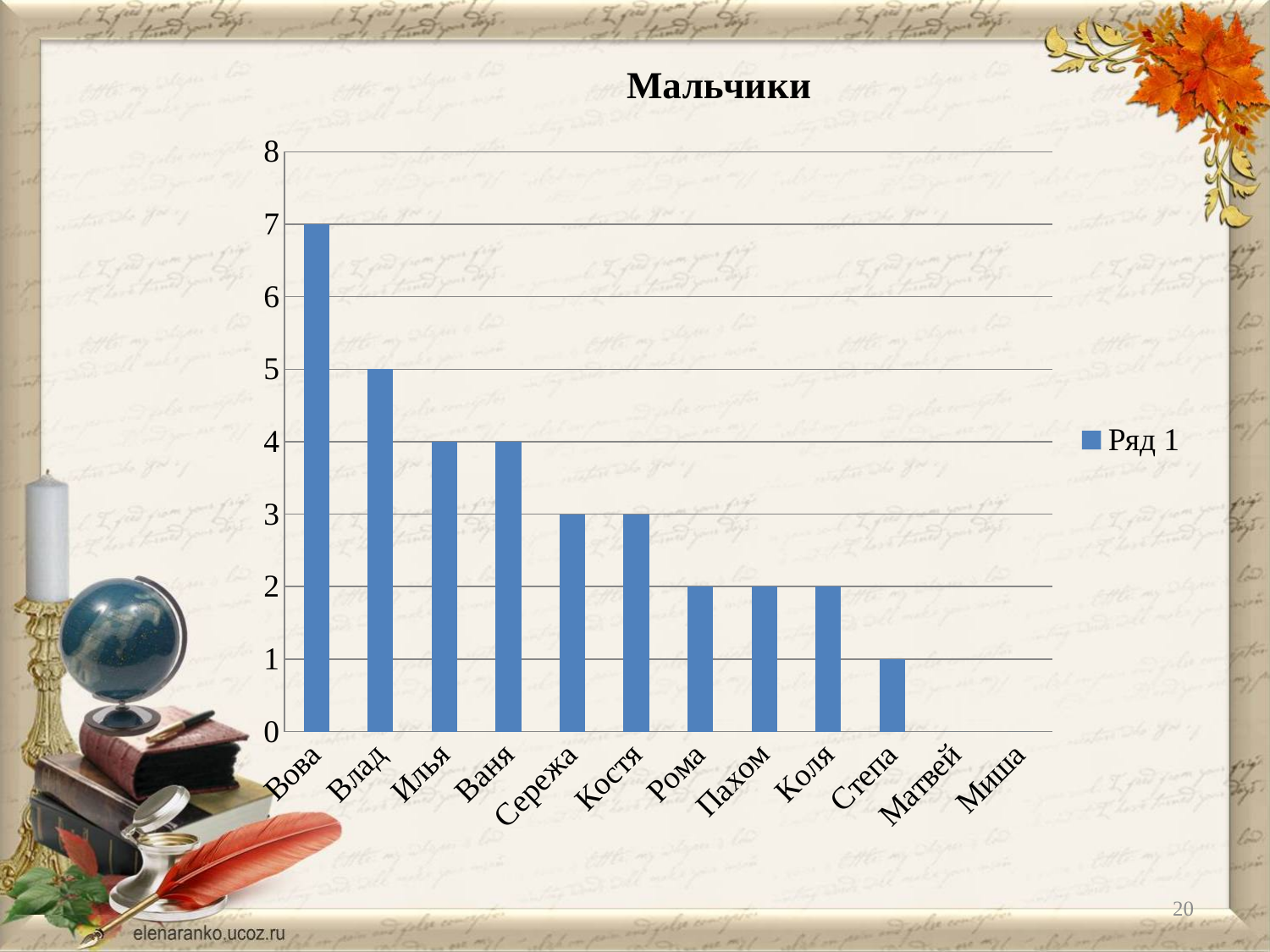
Which category has the highest value? Вова What kind of chart is shown on the slide? bar chart What is the value for Вова? 7 What is the value for Влад? 5 What is the value for Сережа? 3 Do the values rise or fall from left to right along the x axis? fall What is the title of the chart? Мальчики Which is larger, the value for Илья or the value for Костя? Илья What is the value for Степа? 1 How many categories are shown on the x axis? 12 What is the difference between the values for Вова and Влад? 2 How many series does the legend list? 1